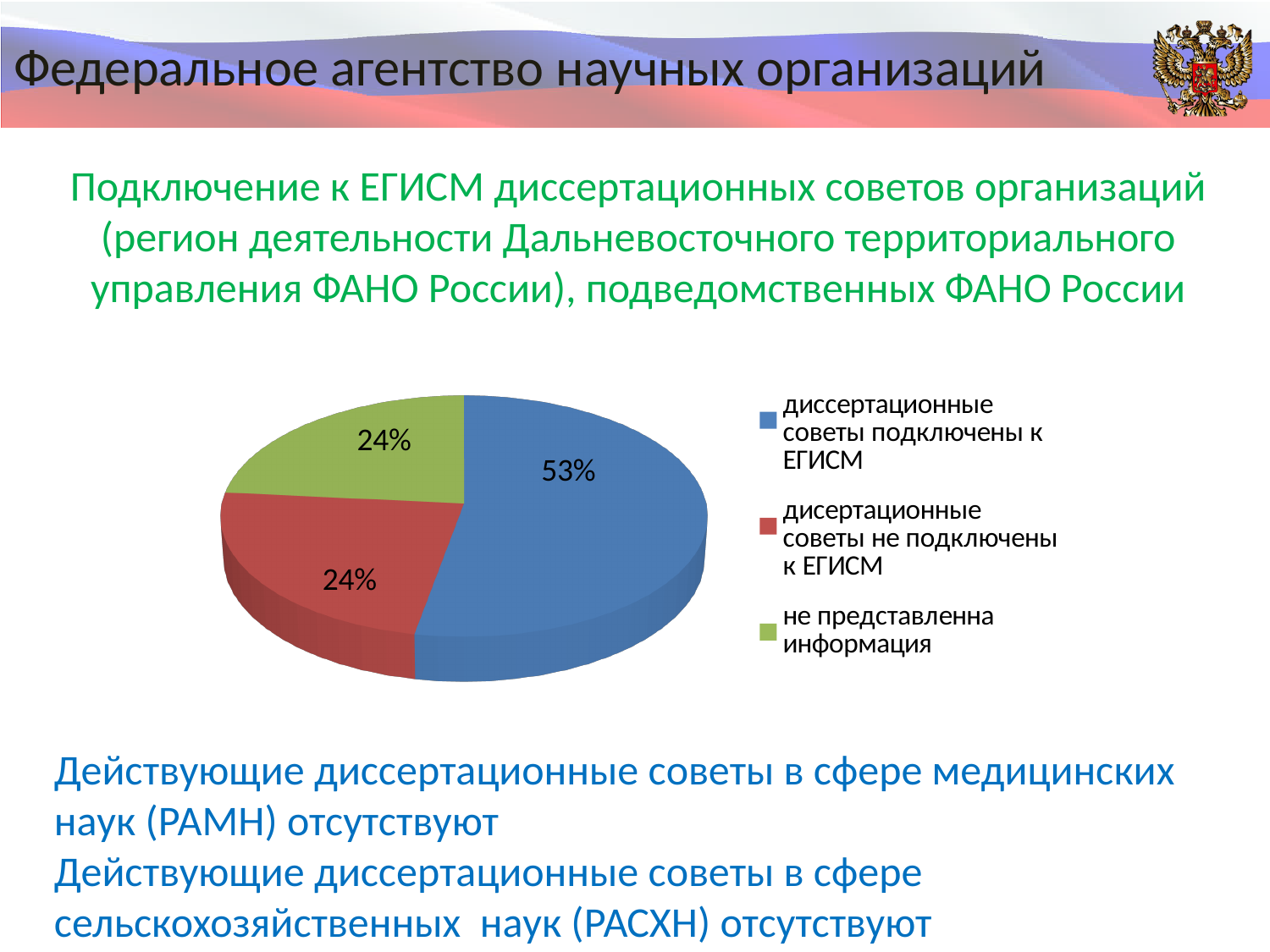
What share of the pie is labelled "не представленна информация"? 24% What kind of chart is shown on the slide? pie chart How many slices does the pie chart have? 3 What colour is the largest slice of the pie? blue How many entries does the legend list? 3 What colour is the slice labelled "не представленна информация"? green Which is larger: the slice for councils connected to ЕГИСМ or the slice for councils not connected to ЕГИСМ? диссертационные советы подключены к ЕГИСМ What share of the pie is labelled "дисертационные советы не подключены к ЕГИСМ"? 24% Which category has the largest slice of the pie? диссертационные советы подключены к ЕГИСМ What is the difference in percentage points between the slice for councils connected to ЕГИСМ and the slice for councils not connected to ЕГИСМ? 29 What share of the pie is labelled "диссертационные советы подключены к ЕГИСМ"? 53% Is the share of councils connected to ЕГИСМ greater or less than 50%? greater